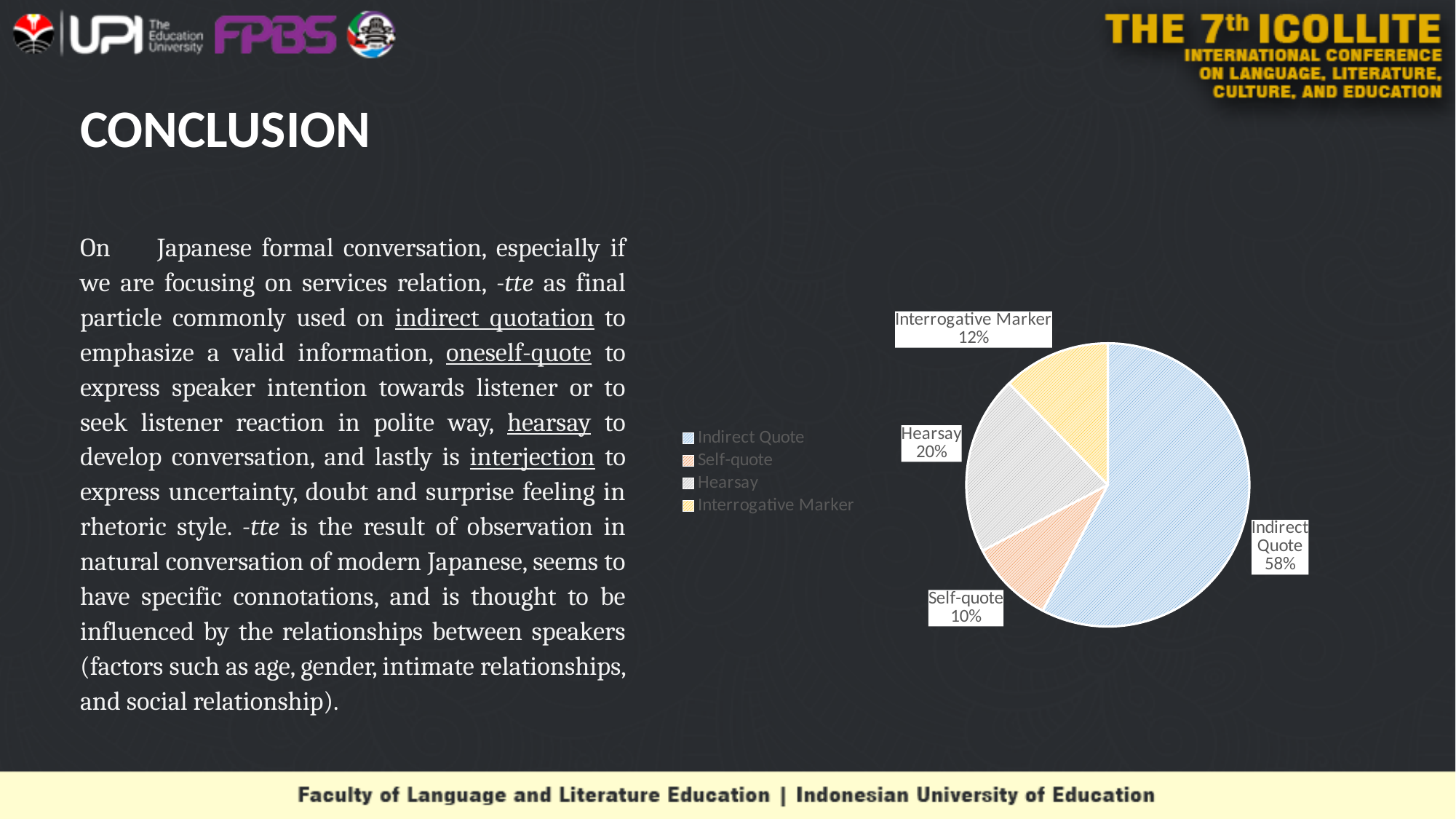
Which legend entry is shown in yellow? Interrogative Marker How many categories are shown in the pie chart? 4 Which is larger in the pie chart, Hearsay or Interrogative Marker? Hearsay How many entries does the chart legend list? 4 What is the difference in percentage points between Indirect Quote and Hearsay? 38 Which category has the smallest slice of the pie chart? Self-quote What share of the pie chart does Indirect Quote account for? 58% Which category has the largest slice of the pie chart? Indirect Quote What percentage is shown for Self-quote in the pie chart? 10% What percentage is shown for Interrogative Marker in the pie chart? 12% What kind of chart is shown on the slide? Pie chart What percentage is shown for Hearsay in the pie chart? 20%